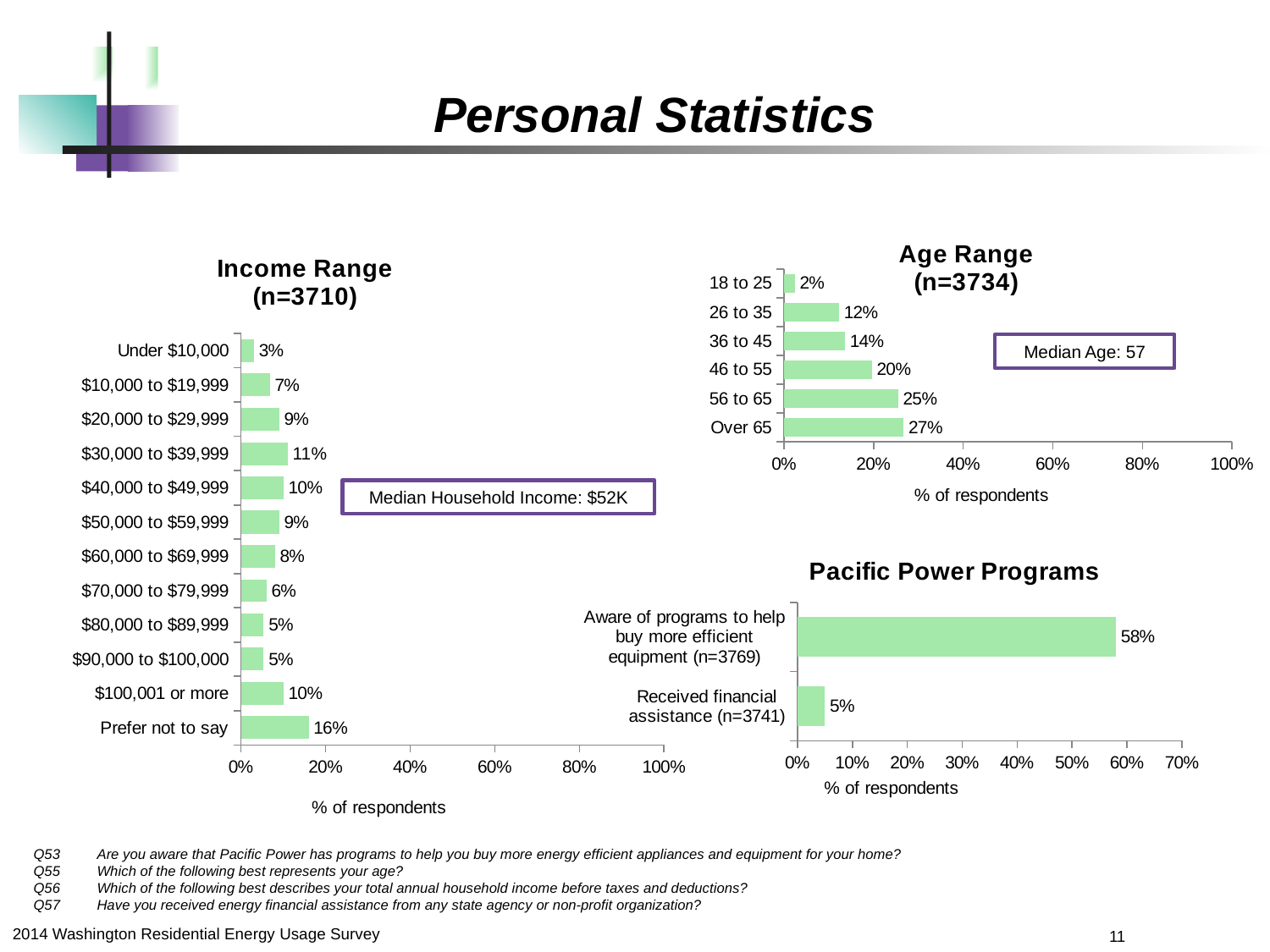
In the Income Range chart, which income category has the lowest percentage of respondents? Under $10,000 In the Pacific Power Programs chart, which is larger: the percentage aware of programs to help buy more efficient equipment or the percentage that received financial assistance? Aware of programs to help buy more efficient equipment In the Age Range chart, do the percentages rise or fall as the age groups get older? Rise In the Pacific Power Programs chart, what percentage of respondents are aware of programs to help buy more efficient equipment? 58% In the Income Range chart, what is the difference between the percentage for Prefer not to say and the percentage for $100,001 or more? 6% In the Income Range chart, how many categories are shown? 12 In the Income Range chart, what percentage of respondents reported an income of $30,000 to $39,999? 11% In the Age Range chart, what percentage of respondents are aged 46 to 55? 20% What type of chart is the Pacific Power Programs chart? Bar chart In the Income Range chart, which category has the highest percentage of respondents? Prefer not to say In the Age Range chart, what is the difference between the percentage for Over 65 and the percentage for 18 to 25? 25% In the Age Range chart, which age group has the highest percentage of respondents? Over 65